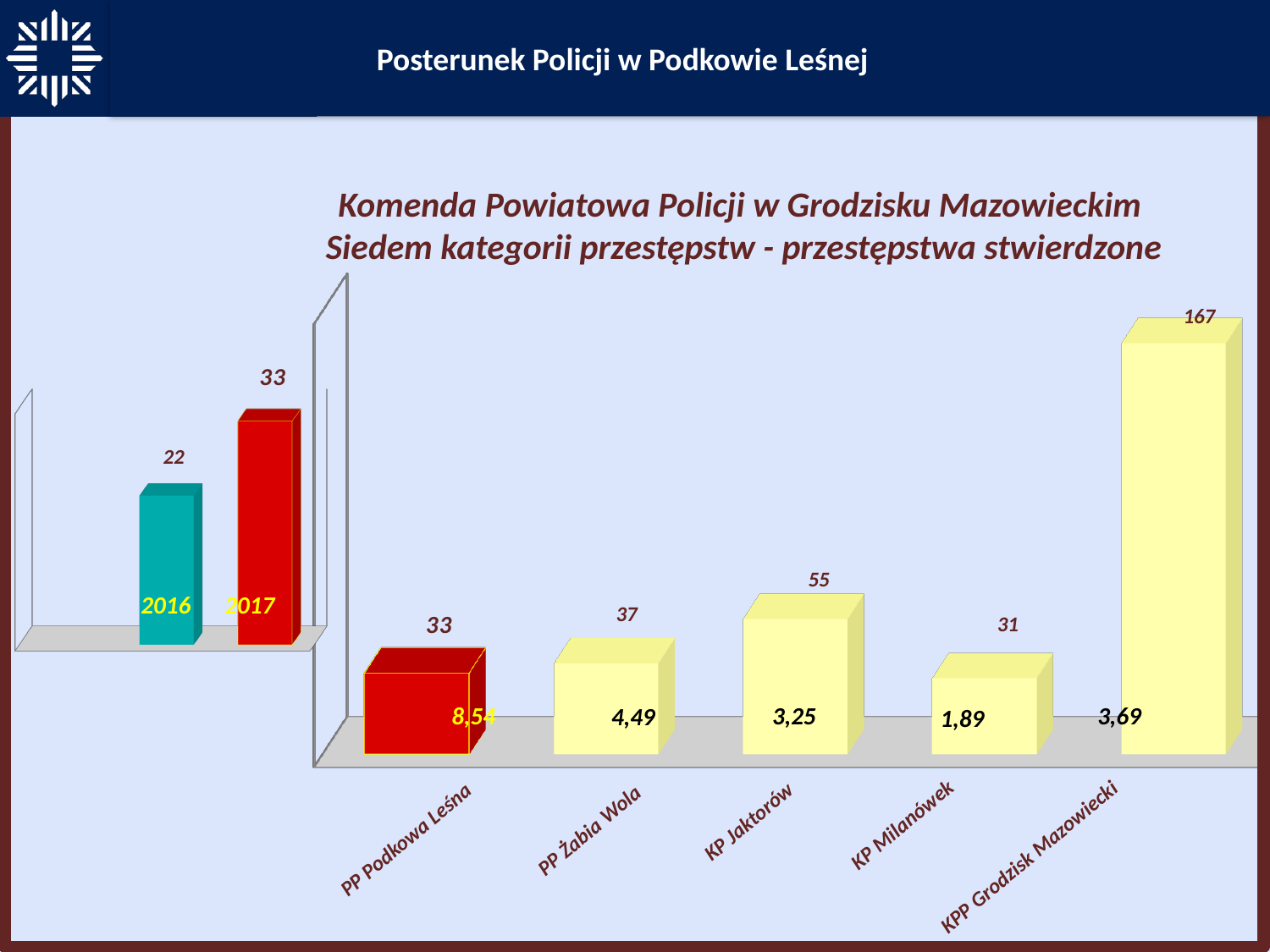
In the main chart titled 'Komenda Powiatowa Policji w Grodzisku Mazowieckim', what is the difference between the values for KPP Grodzisk Mazowiecki and KP Jaktorów? 112 In the small chart on the left of the slide, what is the value for 2017? 33 In the main chart titled 'Komenda Powiatowa Policji w Grodzisku Mazowieckim', which category has the highest value? KPP Grodzisk Mazowiecki In the small chart on the left of the slide, what is the difference between the values for 2017 and 2016? 11 In the main chart titled 'Komenda Powiatowa Policji w Grodzisku Mazowieckim', which bar is coloured red rather than yellow? PP Podkowa Leśna How many categories are shown in the main chart titled 'Komenda Powiatowa Policji w Grodzisku Mazowieckim'? 5 In the main chart titled 'Komenda Powiatowa Policji w Grodzisku Mazowieckim', what is the value for KP Jaktorów? 55 In the main chart titled 'Komenda Powiatowa Policji w Grodzisku Mazowieckim', what is the value for PP Żabia Wola? 37 In the main chart titled 'Komenda Powiatowa Policji w Grodzisku Mazowieckim', which is larger, the value for PP Żabia Wola or the value for KP Milanówek? PP Żabia Wola What kind of chart is the main chart titled 'Komenda Powiatowa Policji w Grodzisku Mazowieckim'? bar chart In the main chart titled 'Komenda Powiatowa Policji w Grodzisku Mazowieckim', what is the value for KPP Grodzisk Mazowiecki? 167 In the main chart titled 'Komenda Powiatowa Policji w Grodzisku Mazowieckim', which category has the lowest value? KP Milanówek